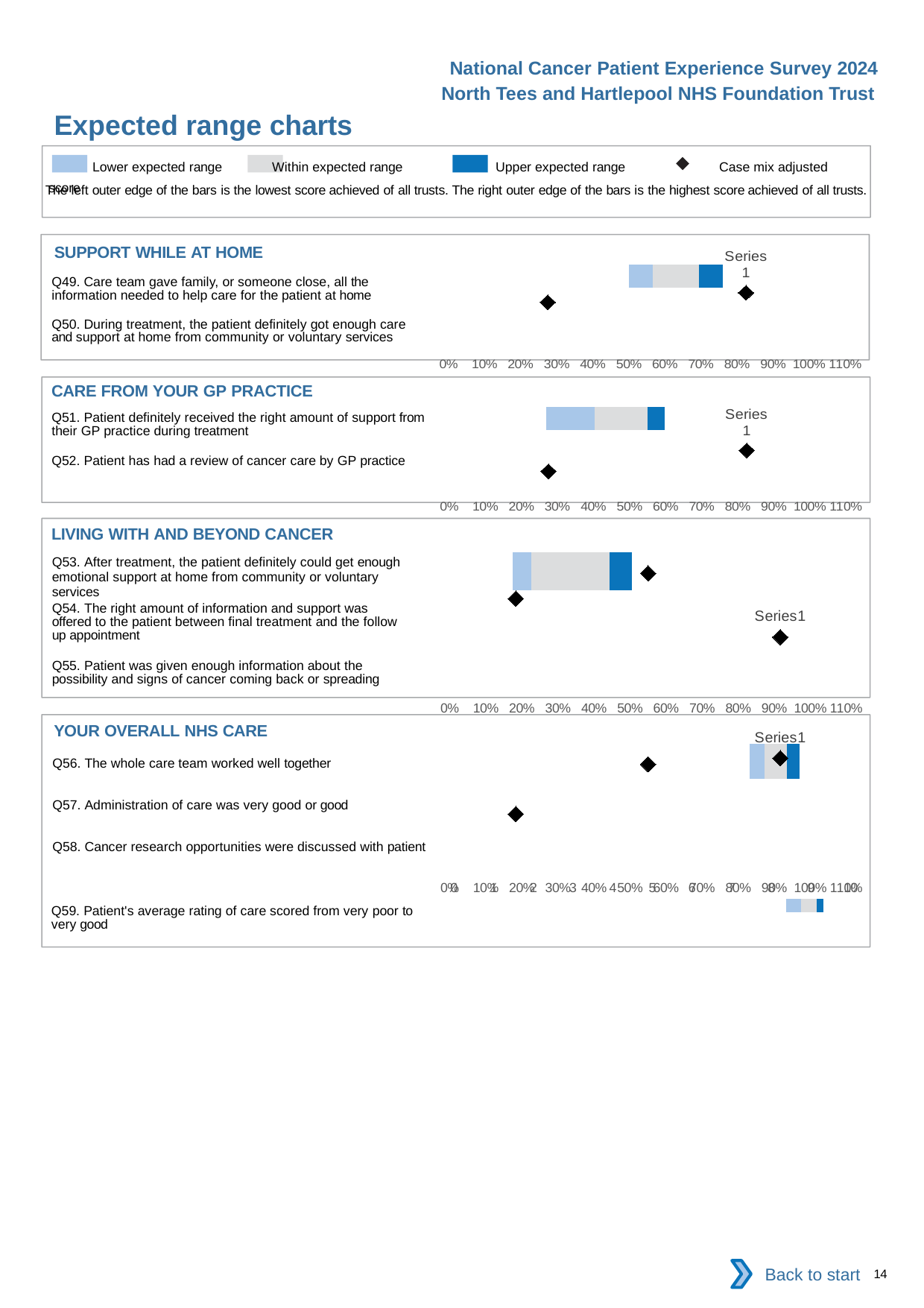
What is the highest percentage tick shown on the x axis of the charts? 110% In the LIVING WITH AND BEYOND CANCER chart, is the leftmost diamond marker greater or less than 30%? less In the YOUR OVERALL NHS CARE chart, is the rightmost diamond marker greater or less than 80%? greater How many questions are listed in the SUPPORT WHILE AT HOME chart? 2 How many questions are listed in the LIVING WITH AND BEYOND CANCER chart? 3 According to the legend, which colour represents the upper expected range? Dark blue In the CARE FROM YOUR GP PRACTICE chart, is the leftmost diamond marker greater or less than 40%? less How many questions are listed in the CARE FROM YOUR GP PRACTICE chart? 2 What kind of chart is used in the SUPPORT WHILE AT HOME section? Bar chart How many entries does the legend at the top of the slide list? 4